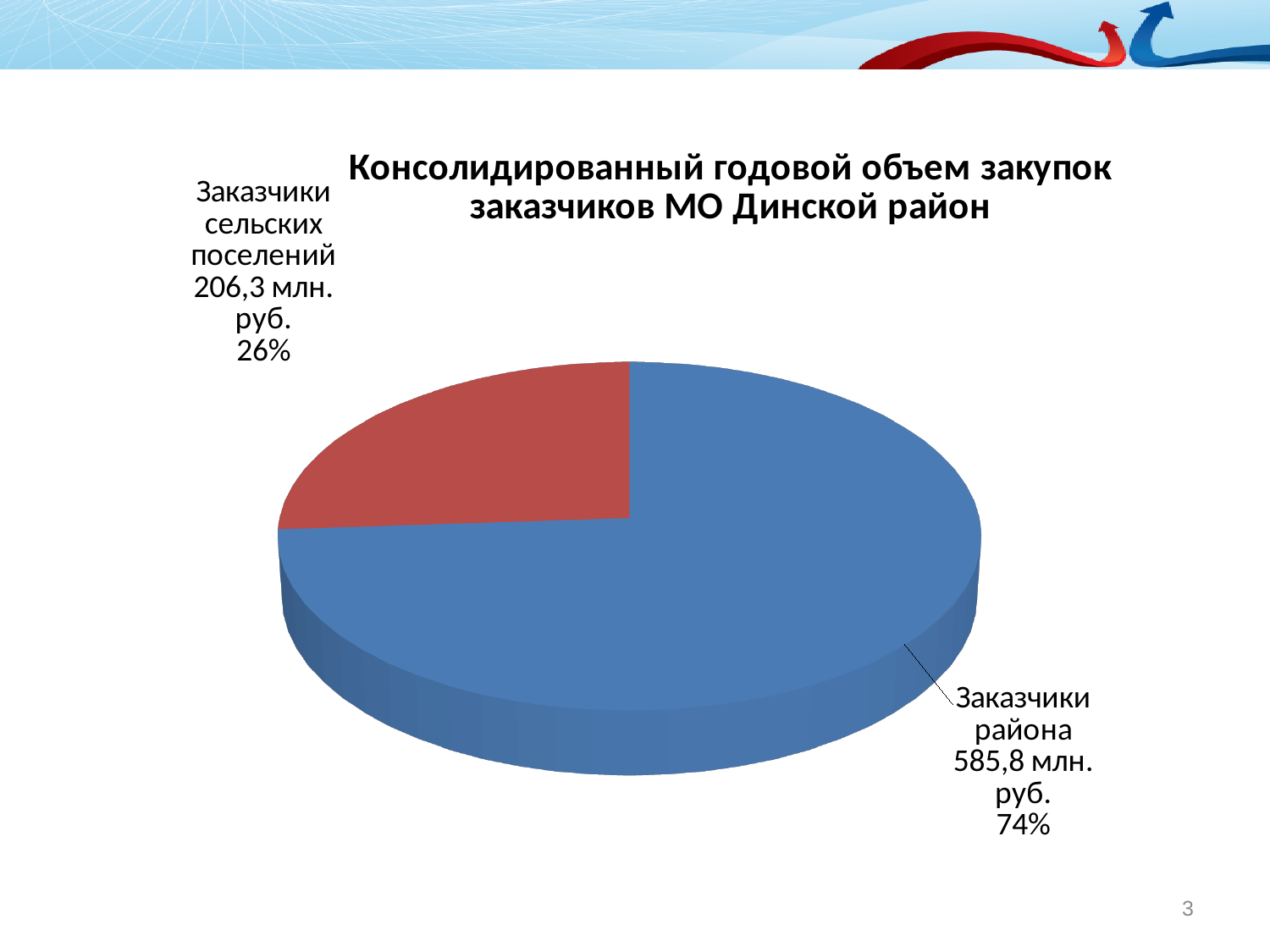
What is the value for Заказчики сельских поселений? 206,3 млн. руб. What is the difference in млн. руб. between Заказчики района and Заказчики сельских поселений? 379,5 млн. руб. Which category has the smallest slice? Заказчики сельских поселений What is the value for Заказчики района? 585,8 млн. руб. What kind of chart is shown on the slide? pie chart What share of the pie does Заказчики сельских поселений represent? 26% What colour is the slice for Заказчики сельских поселений? red Which category has the largest slice? Заказчики района What is the title of the chart? Консолидированный годовой объем закупок заказчиков МО Динской район What share of the pie does Заказчики района represent? 74% Which is larger, Заказчики района or Заказчики сельских поселений? Заказчики района How many slices does the pie chart have? 2